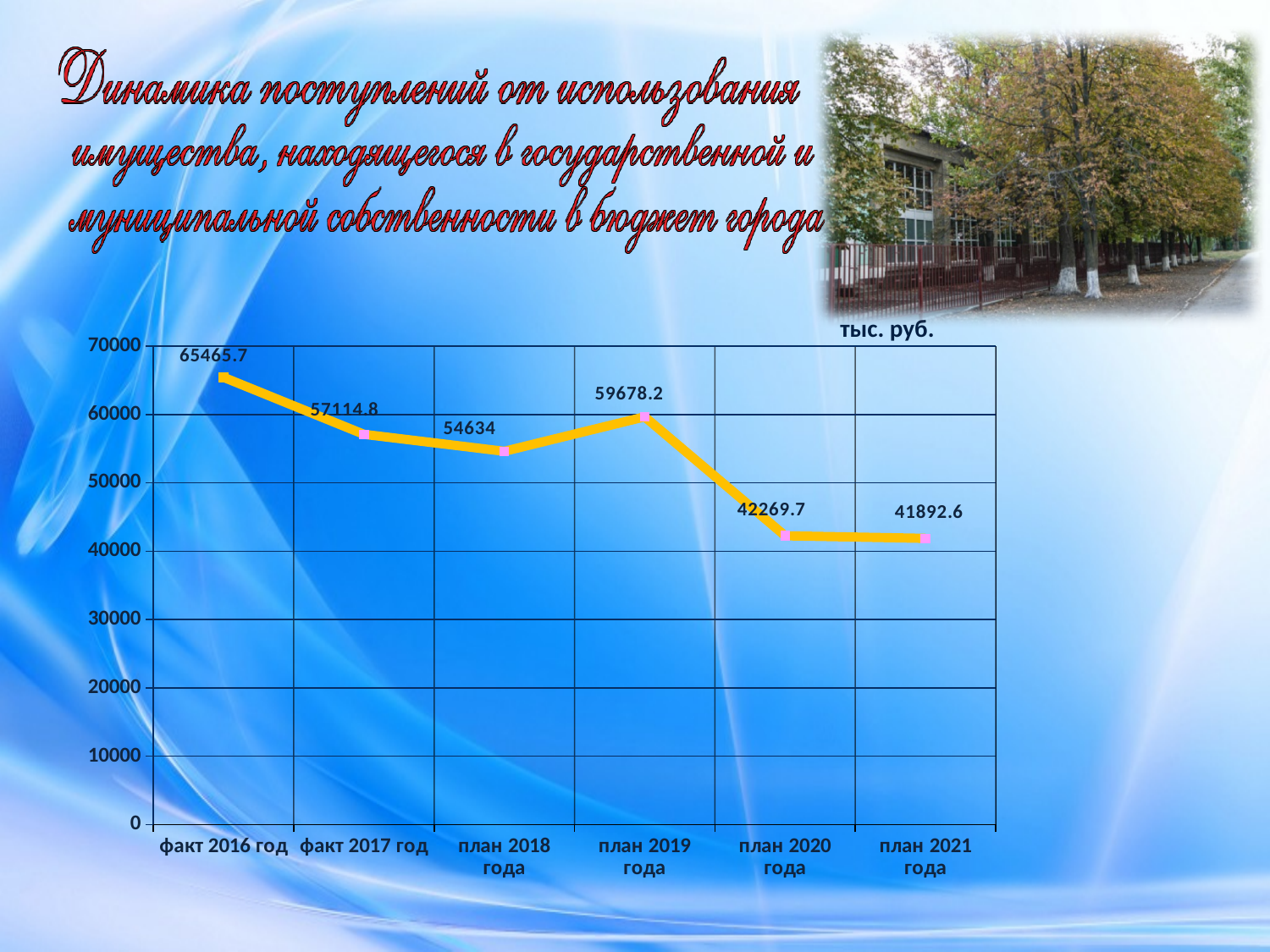
What is the value for факт 2016 год? 65465.7 Which is larger, the value for план 2018 года or the value for план 2019 года? план 2019 года What unit is indicated above the chart? тыс. руб. Which category has the lowest value? план 2021 года What kind of chart is shown on the slide? line chart What is the value for план 2019 года? 59678.2 Which category has the highest value? факт 2016 год What is the difference between the values for факт 2016 год and факт 2017 год? 8350.9 What is the value for план 2021 года? 41892.6 How many categories are shown on the x axis? 6 Is the value for план 2020 года greater or less than 50000? less What is the difference between the values for план 2019 года and план 2020 года? 17408.5